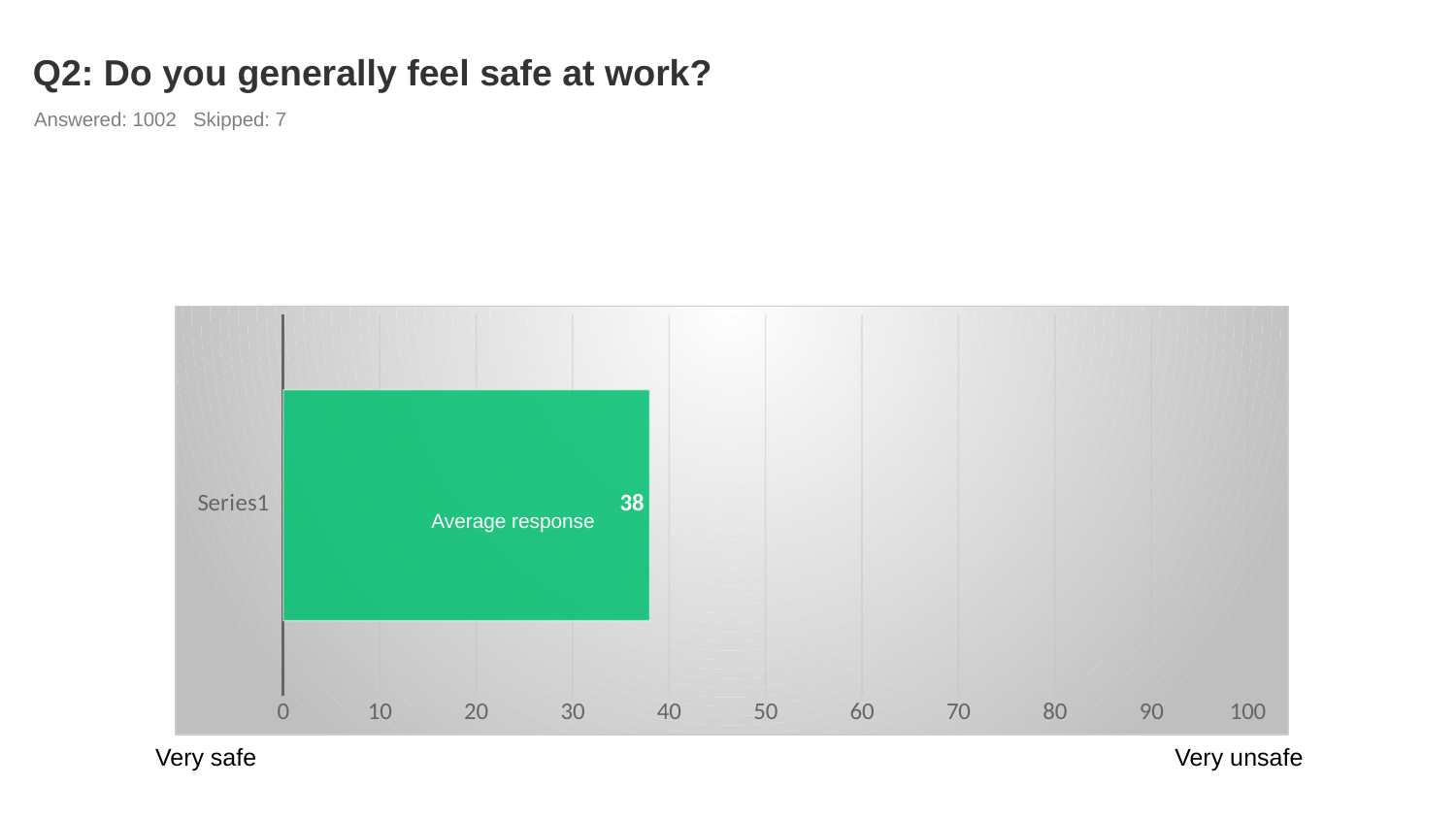
What is the value of the bar labelled Series1? 38 What text label is printed inside the bar? Average response Is the value for Series1 greater or less than 50? less What is the maximum value shown on the horizontal axis? 100 How many responses were answered according to the slide? 1002 What kind of chart is shown on the slide? bar chart What is the title of the chart? Q2: Do you generally feel safe at work? How many responses were skipped according to the slide? 7 Is the value for Series1 greater or less than 30? greater How many bars are plotted in the chart? 1